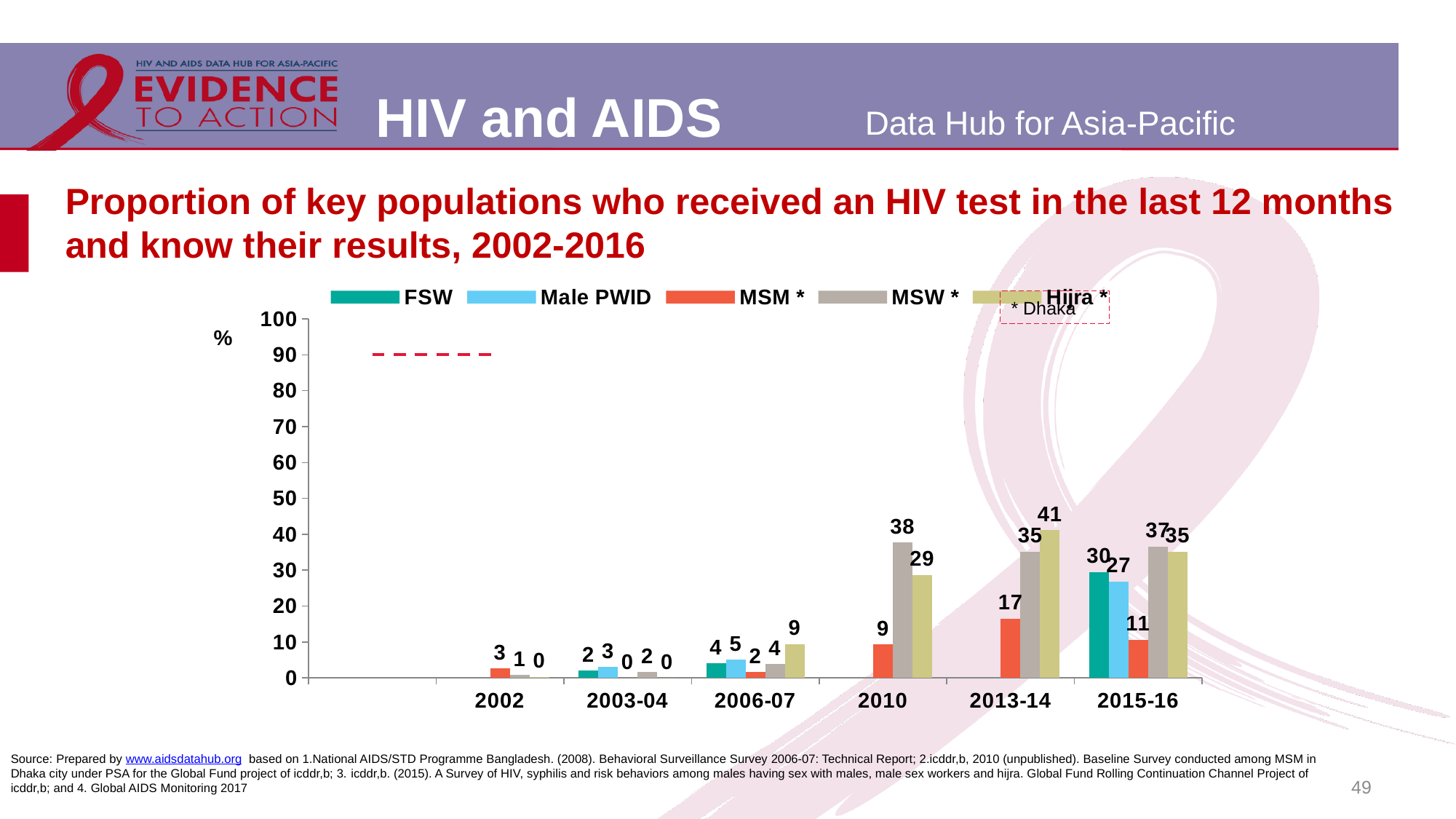
Which key population has the lowest value in 2015-16? MSM * What is the difference between the MSW * and Hijra * values in 2010? 9 What is the value for FSW in 2015-16? 30 Does the MSW * value rise or fall from 2002 to 2010? Rise What is the value for Male PWID in 2006-07? 5 How many series does the legend list? 5 What is the value for MSW * in 2010? 38 How many time periods are shown on the x axis? 6 Which key population has the highest value in 2015-16? MSW * Is the MSM * value larger in 2013-14 or in 2015-16? 2013-14 What is the value for Hijra * in 2013-14? 41 What kind of chart is shown on the slide? Bar chart